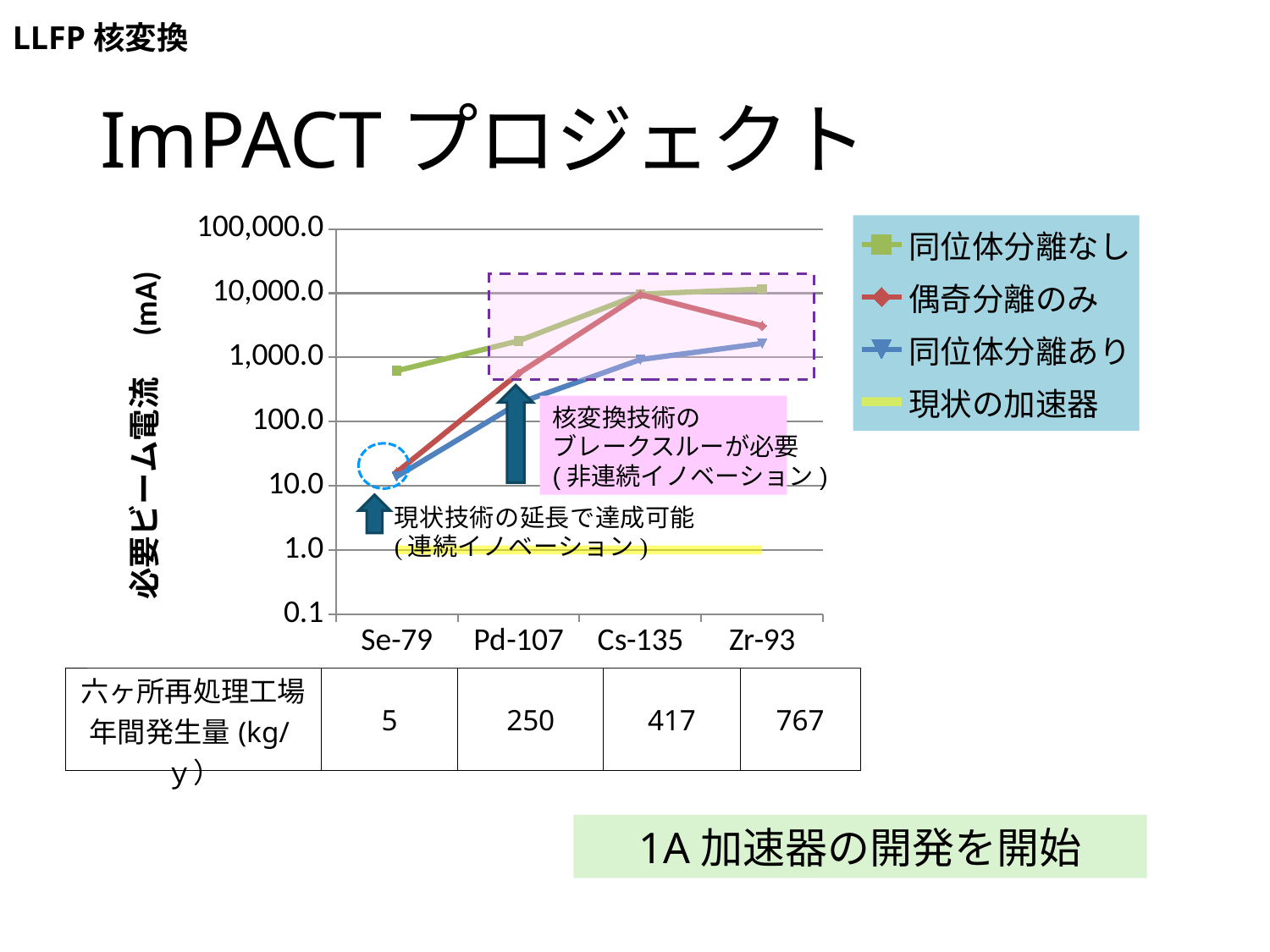
What is the value of the 現状の加速器 line on the chart? 1.0 For the 偶奇分離のみ series, which category has the highest value? Cs-135 What is the title of the y axis of the chart? 必要ビーム電流 (mA) Is the value for 同位体分離あり at Pd-107 greater or less than 100.0? greater How many categories are shown on the x axis of the chart? 4 What kind of chart is shown on the slide? line chart For the 同位体分離なし series, which category has the lowest value? Se-79 How many series does the chart legend list? 4 Is the value for 同位体分離なし at Se-79 greater or less than 100.0? greater Is the value for 偶奇分離のみ at Zr-93 greater or less than 10,000.0? less At Pd-107, which series has the larger value: 同位体分離なし or 同位体分離あり? 同位体分離なし